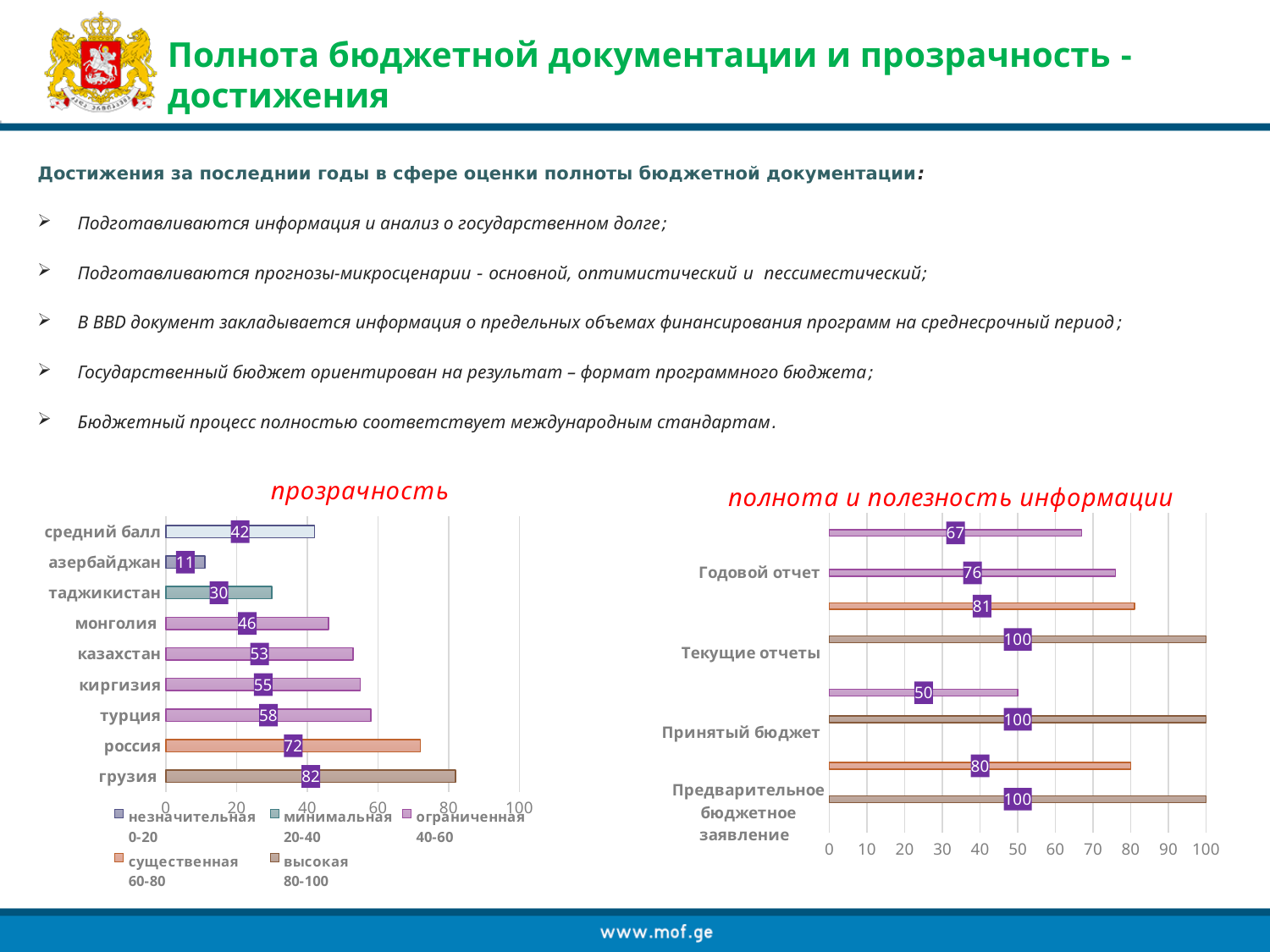
On the 'прозрачность' chart, what is the difference between the values for россия and казахстан? 19 On the 'прозрачность' chart, what is the value for азербайджан? 11 On the 'прозрачность' chart, which country has the highest value? грузия On the 'прозрачность' chart, what is the value for средний балл? 42 On the 'прозрачность' chart, which country has the lowest value? азербайджан How many entries does the legend of the 'прозрачность' chart list? 5 What type of chart is the 'полнота и полезность информации' chart? bar chart On the 'прозрачность' chart, how many categories (bars) are shown? 9 On the 'прозрачность' chart, what is the value for турция? 58 On the 'полнота и полезность информации' chart, what is the lowest value labelled on any bar? 50 On the 'прозрачность' chart, what is the value for грузия? 82 On the 'прозрачность' chart, which is larger, the value for монголия or the value for таджикистан? монголия